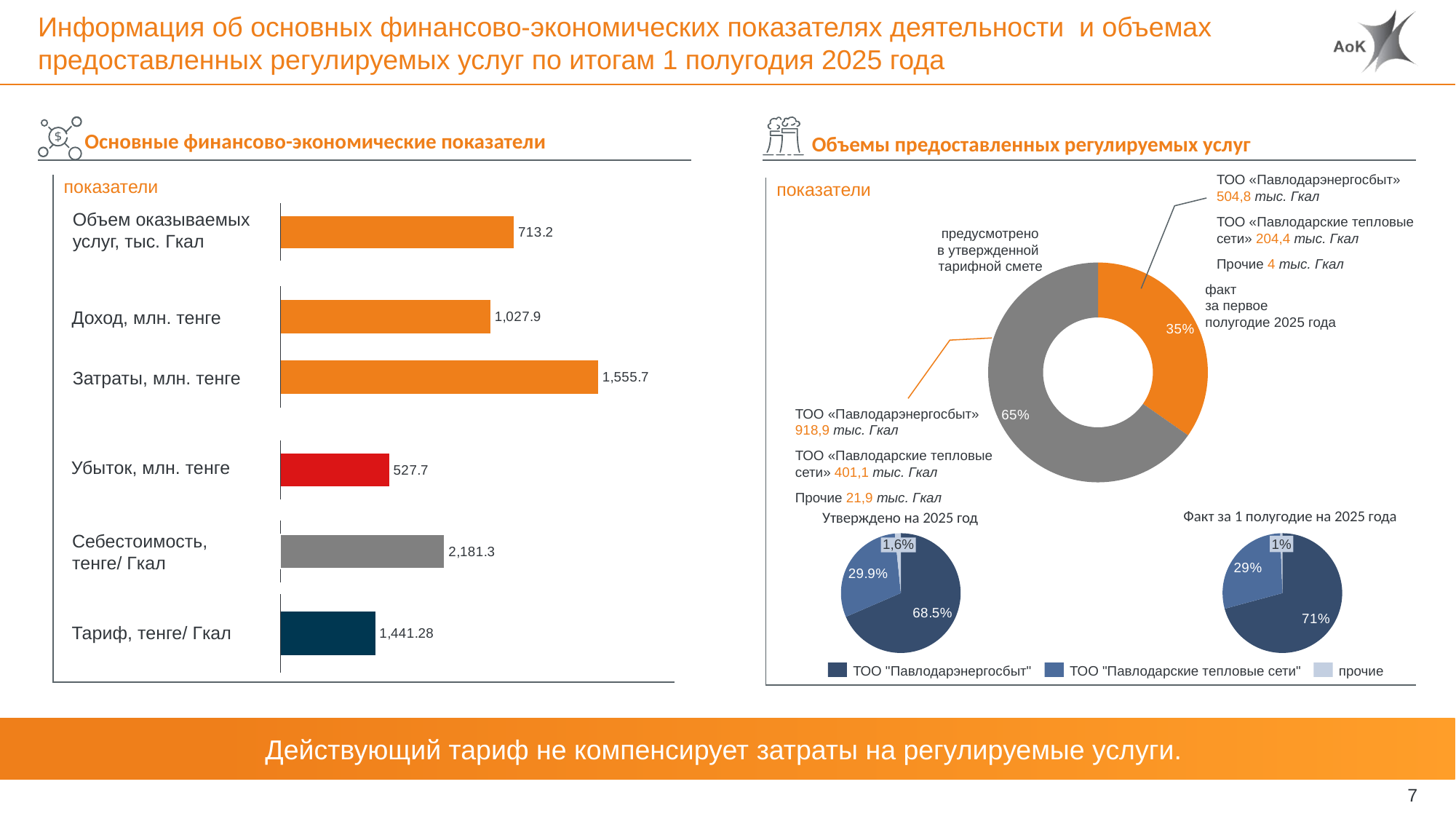
In the bar chart 'Основные финансово-экономические показатели', what is the difference between 'Затраты, млн. тенге' and 'Доход, млн. тенге'? 527.8 In the pie chart 'Факт за 1 полугодие на 2025 года', what share does ТОО "Павлодарэнергосбыт" have? 71% In the large donut chart on the right, what share is labelled 'факт за первое полугодие 2025 года'? 35% In the pie chart 'Утверждено на 2025 год', what share does ТОО "Павлодарские тепловые сети" have? 29.9% In the bar chart 'Основные финансово-экономические показатели', which is larger: 'Себестоимость, тенге/ Гкал' or 'Тариф, тенге/ Гкал'? Себестоимость, тенге/ Гкал How many categories are shown in the bar chart 'Основные финансово-экономические показатели'? 6 What type of chart is 'Основные финансово-экономические показатели'? Bar chart In the bar chart 'Основные финансово-экономические показатели', which category has the highest value? Себестоимость, тенге/ Гкал How many entries does the legend below the two small pie charts list? 3 In the bar chart 'Основные финансово-экономические показатели', what is the value for 'Затраты, млн. тенге'? 1,555.7 In the bar chart 'Основные финансово-экономические показатели', what is the value for 'Тариф, тенге/ Гкал'? 1,441.28 In the bar chart 'Основные финансово-экономические показатели', which category has the lowest value? Убыток, млн. тенге